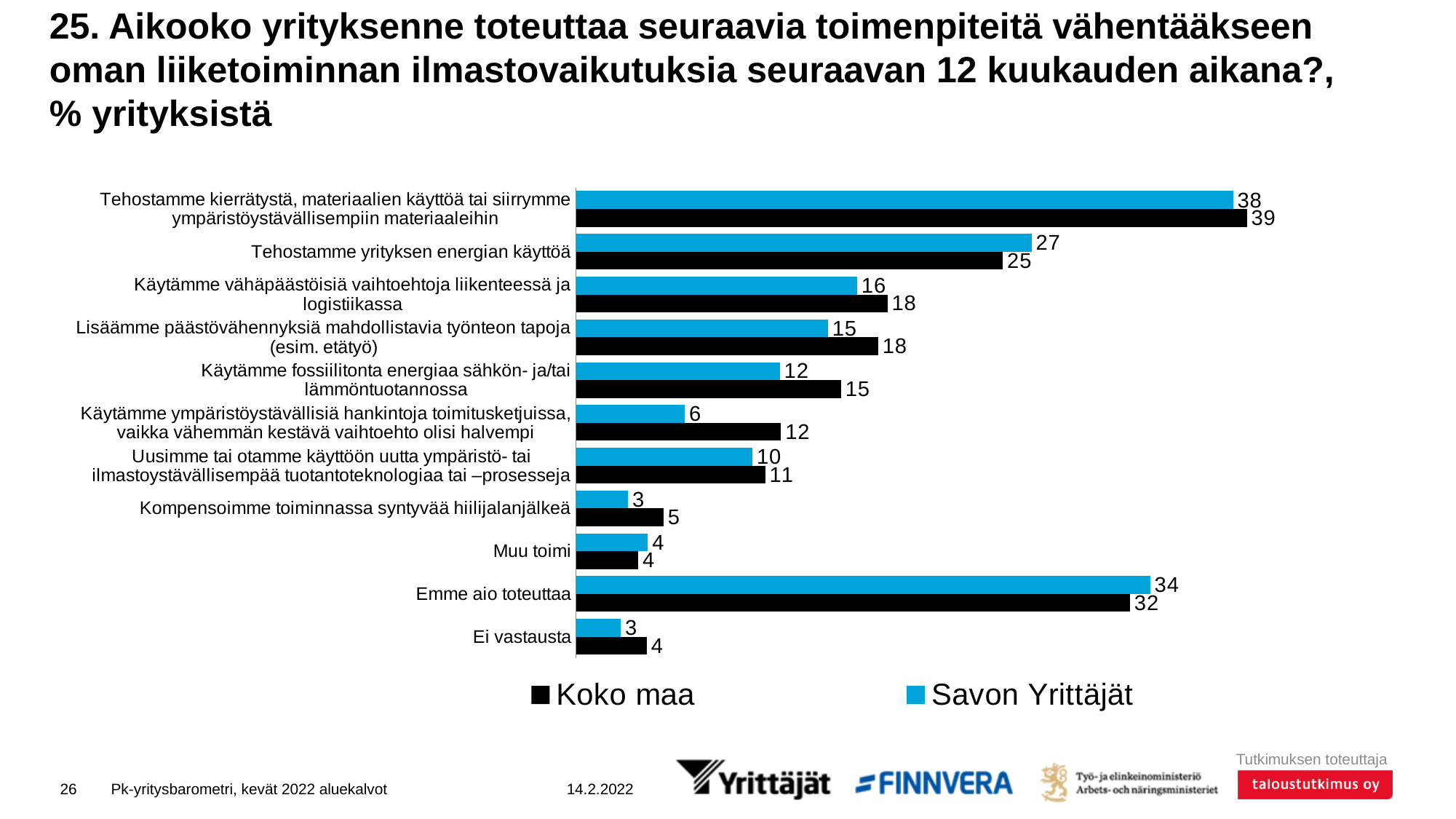
Which category has the lowest value for Koko maa? Muu toimi and Ei vastausta (both 4) Which category has the highest value for Koko maa? Tehostamme kierrätystä, materiaalien käyttöä tai siirrymme ympäristöystävällisempiin materiaaleihin What is the difference between the Koko maa and Savon Yrittäjät values for "Käytämme ympäristöystävällisiä hankintoja toimitusketjuissa, vaikka vähemmän kestävä vaihtoehto olisi halvempi"? 6 For "Emme aio toteuttaa", which series has the larger value, Koko maa or Savon Yrittäjät? Savon Yrittäjät How many series does the legend list? 2 What is the value for Koko maa for "Emme aio toteuttaa"? 32 Which colour represents the Savon Yrittäjät series? Blue What kind of chart is shown on the slide? Bar chart What is the value for Savon Yrittäjät for "Tehostamme yrityksen energian käyttöä"? 27 How many categories are shown in the chart? 11 For "Lisäämme päästövähennyksiä mahdollistavia työnteon tapoja (esim. etätyö)", which series has the larger value, Koko maa or Savon Yrittäjät? Koko maa What is the value for Koko maa for "Käytämme ympäristöystävällisiä hankintoja toimitusketjuissa, vaikka vähemmän kestävä vaihtoehto olisi halvempi"? 12